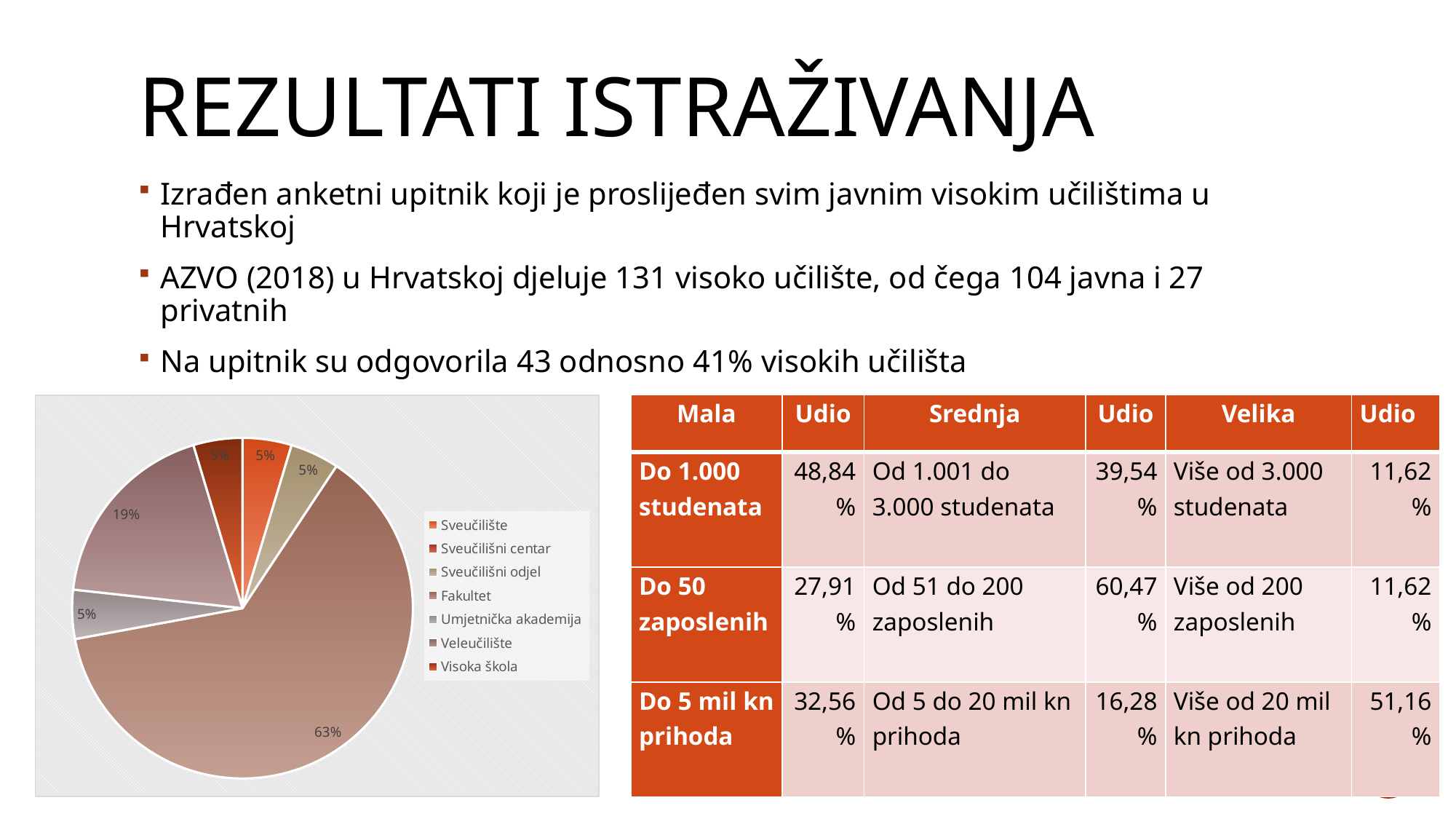
In the pie chart, what share is labelled for the Veleučilište slice? 19% Which category has the largest slice in the pie chart? Fakultet In the pie chart, what share is labelled for the Sveučilište slice? 5% In the pie chart, which slice is larger: Veleučilište or Visoka škola? Veleučilište What kind of chart is shown on the slide? pie chart What is the first entry listed in the pie chart's legend? Sveučilište In the pie chart, which slice is larger: Fakultet or Veleučilište? Fakultet In the pie chart, what share is labelled for the Fakultet slice? 63% What is the last entry listed in the pie chart's legend? Visoka škola How many entries does the legend of the pie chart list? 7 In the pie chart, what is the difference in percentage points between the Fakultet slice and the Veleučilište slice? 44 percentage points In the pie chart, what share is labelled for the Visoka škola slice? 5%